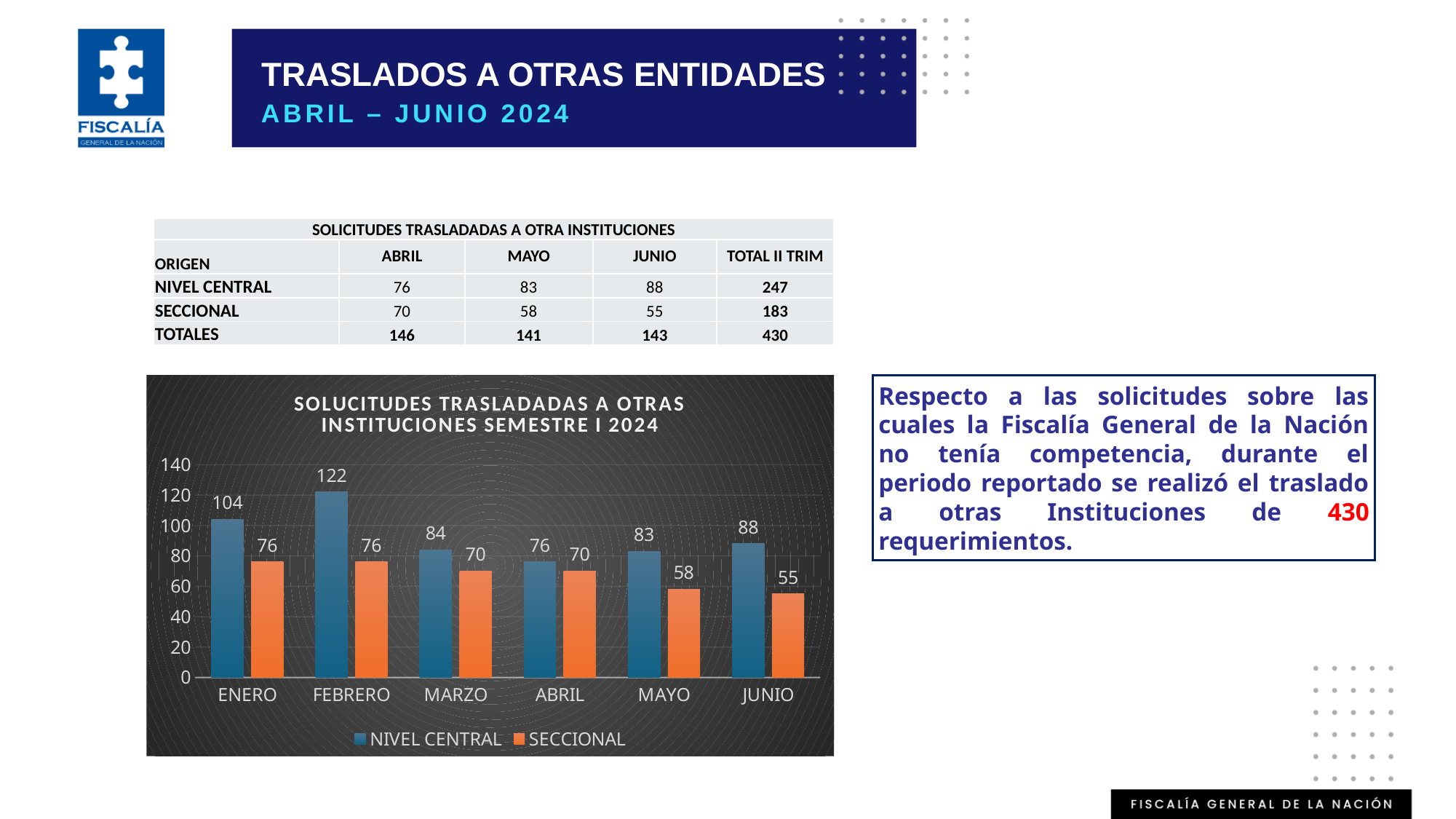
What kind of chart is shown on the slide? bar chart Is the value for NIVEL CENTRAL in MARZO greater or less than 100? less What is the value for NIVEL CENTRAL in JUNIO? 88 Which month has the lowest SECCIONAL value? JUNIO What is the difference between NIVEL CENTRAL and SECCIONAL in ENERO? 28 How many months are shown on the x axis of the chart? 6 Which month has the highest NIVEL CENTRAL value? FEBRERO Does the SECCIONAL series rise or fall from MARZO to JUNIO? fall Which is larger in ABRIL, NIVEL CENTRAL or SECCIONAL? NIVEL CENTRAL What is the value for SECCIONAL in MAYO? 58 How many series does the chart legend list? 2 What is the value for NIVEL CENTRAL in FEBRERO? 122